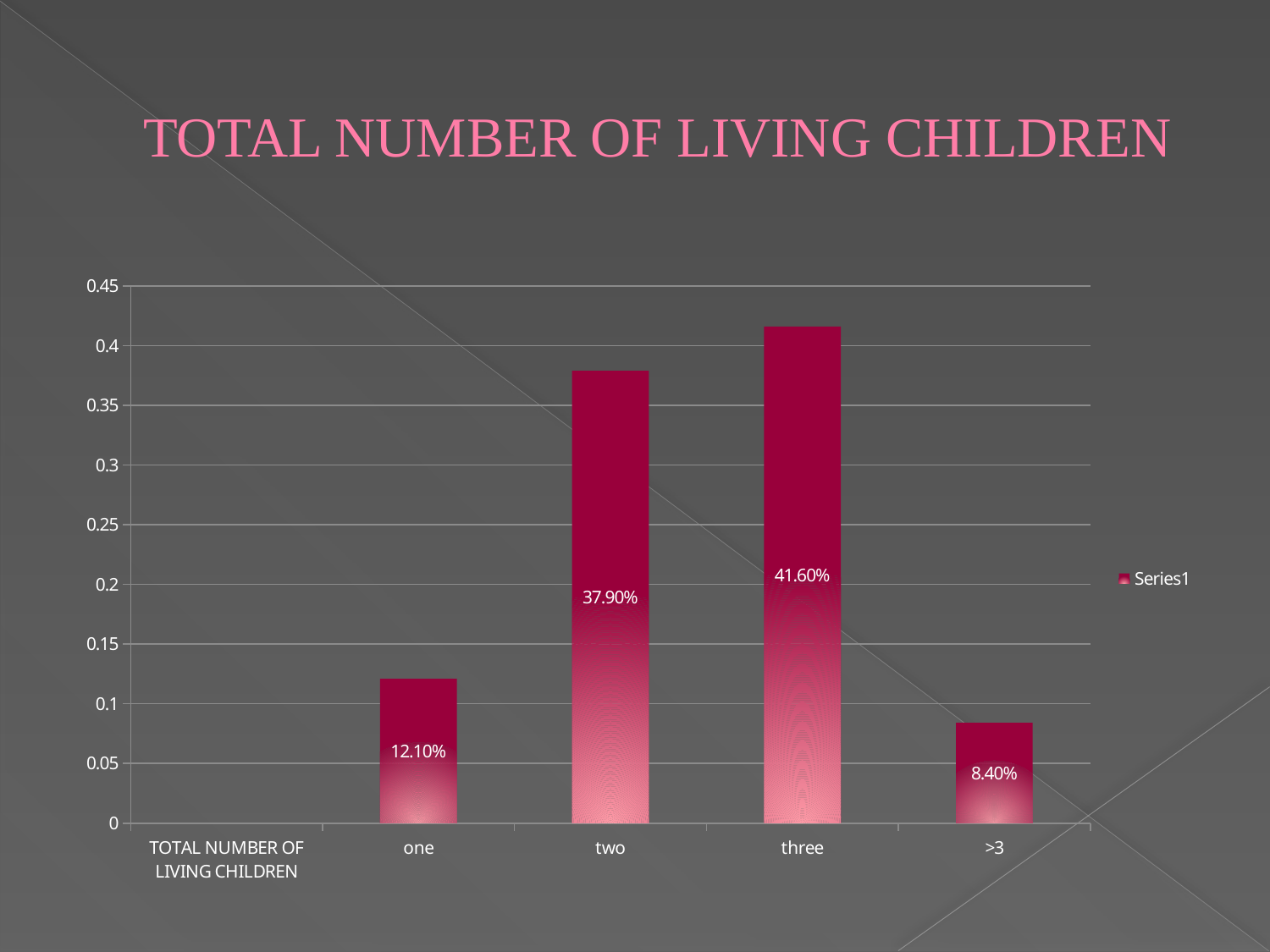
What kind of chart is shown on the slide? bar chart How many bars are plotted in the chart? 4 Which is larger, the value for "one" or the value for ">3"? one What is the value for the category "one"? 12.10% What is the value for the category "three"? 41.60% Which category has the lowest value? >3 What is the value for the category ">3"? 8.40% What is the difference between the values for "three" and "two"? 3.70% What is the value for the category "two"? 37.90% Which category has the highest value? three Is the value for "two" greater or less than 0.35 on the axis? greater What is the difference between the values for "one" and ">3"? 3.70%